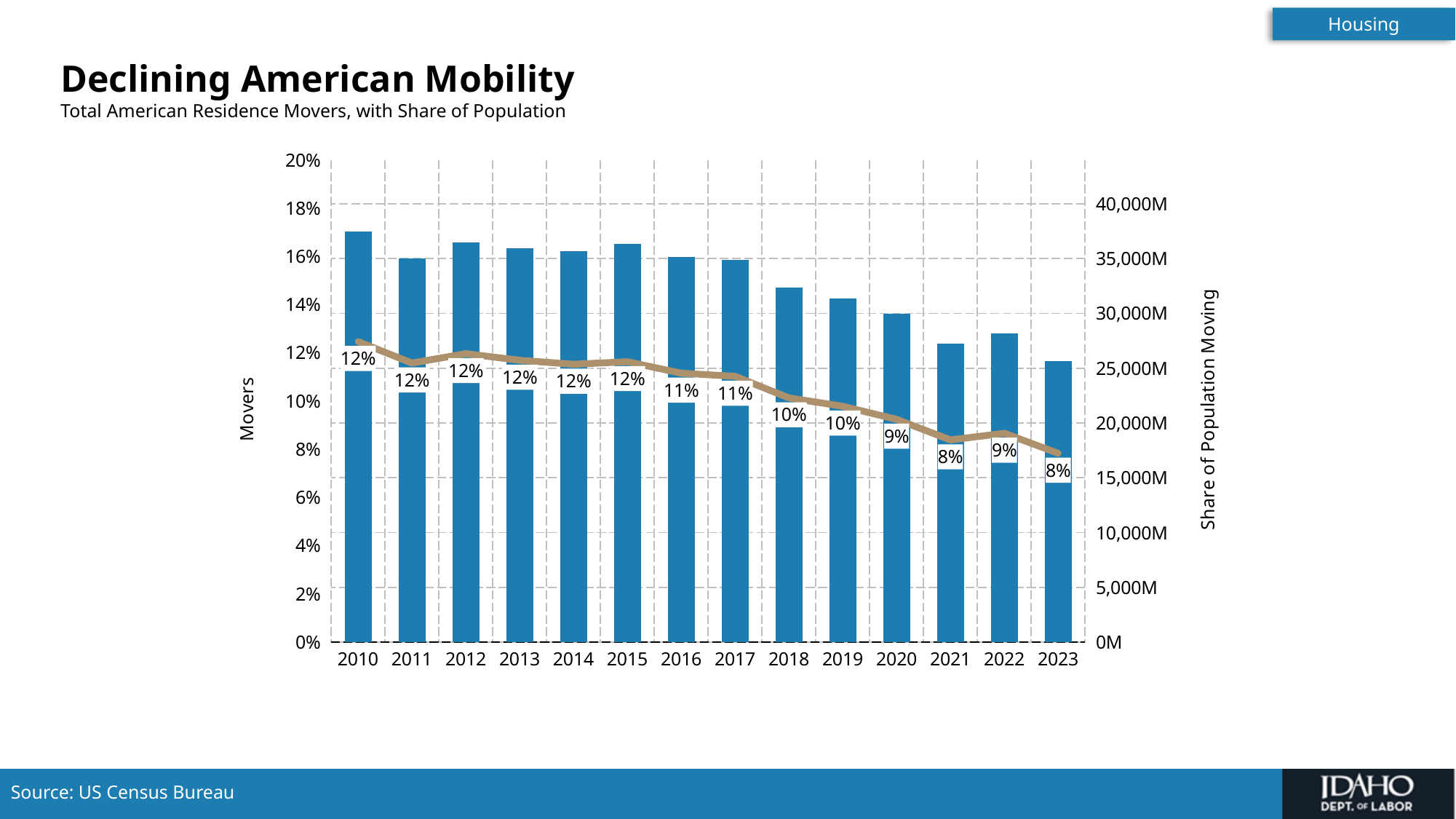
Which year has the shortest bar for total movers? 2023 What is the share of population moving shown for 2023? 8% What is the share of population moving shown for 2018? 10% Does the share of population moving rise or fall from 2010 to 2023? Fall Is the total movers bar for 2023 greater or less than 30,000M? less Which year has the tallest bar for total movers? 2010 How many years are shown on the x axis? 14 What is the share of population moving shown for 2010? 12% What is the share of population moving shown for 2020? 9% By how many percentage points did the share of population moving fall from 2010 to 2023? 4 percentage points Which year has a taller bar for total movers, 2010 or 2011? 2010 What kind of chart is this? A bar chart with a line overlay